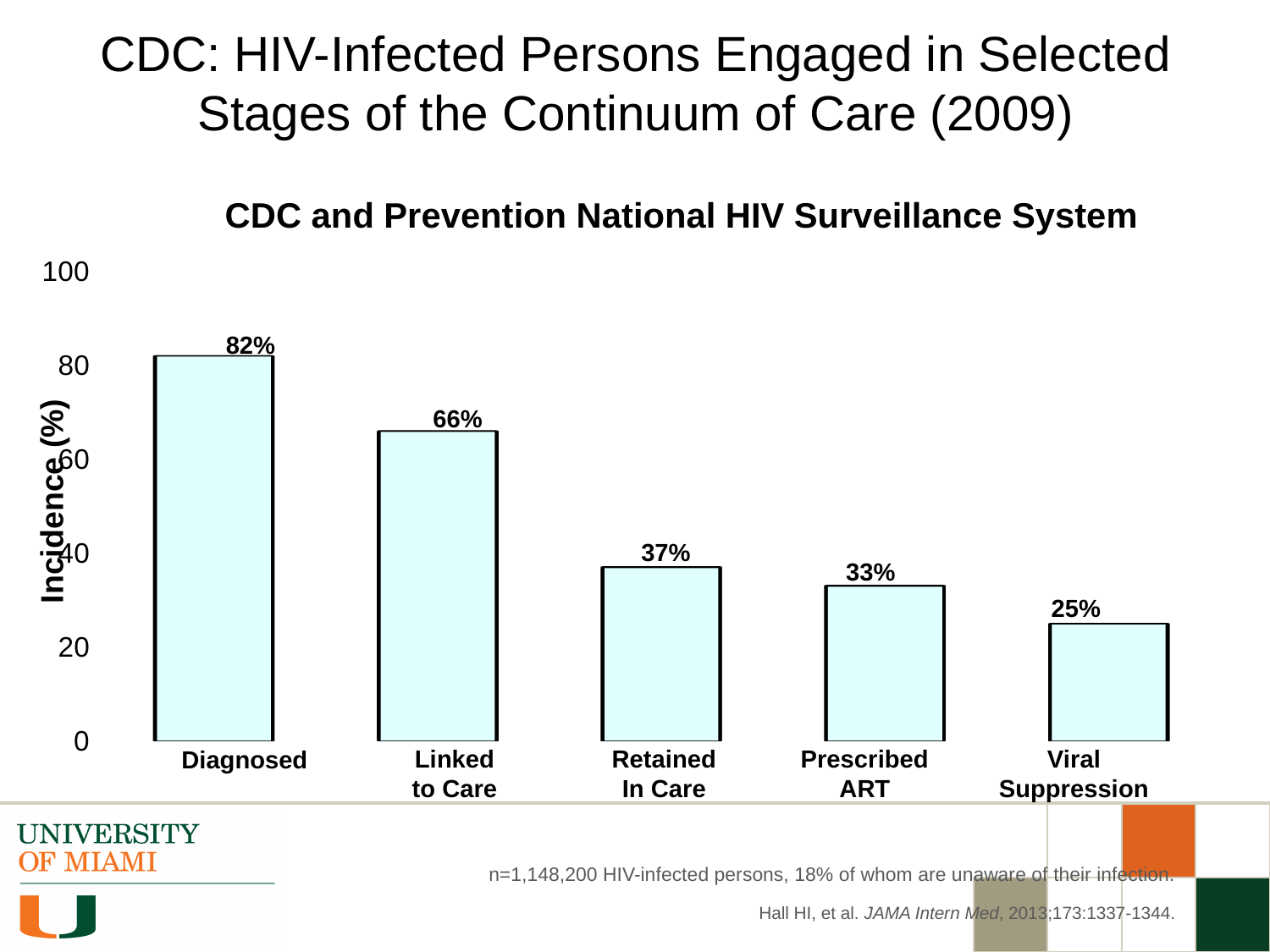
What is the value for Viral Suppression? 25% How many stages of care are shown on the chart? 5 Which stage has the lowest value? Viral Suppression What is the difference between Retained In Care and Prescribed ART? 4% Which is larger, Linked to Care or Retained In Care? Linked to Care What is the difference between the Diagnosed and Linked to Care values? 16% What is the value for Prescribed ART? 33% What kind of chart is shown on the slide? Bar chart What is the label of the y axis? Incidence (%) Which stage of the continuum of care has the highest value? Diagnosed What percentage of HIV-infected persons were Diagnosed? 82% Is the value for Retained In Care greater or less than 40? less